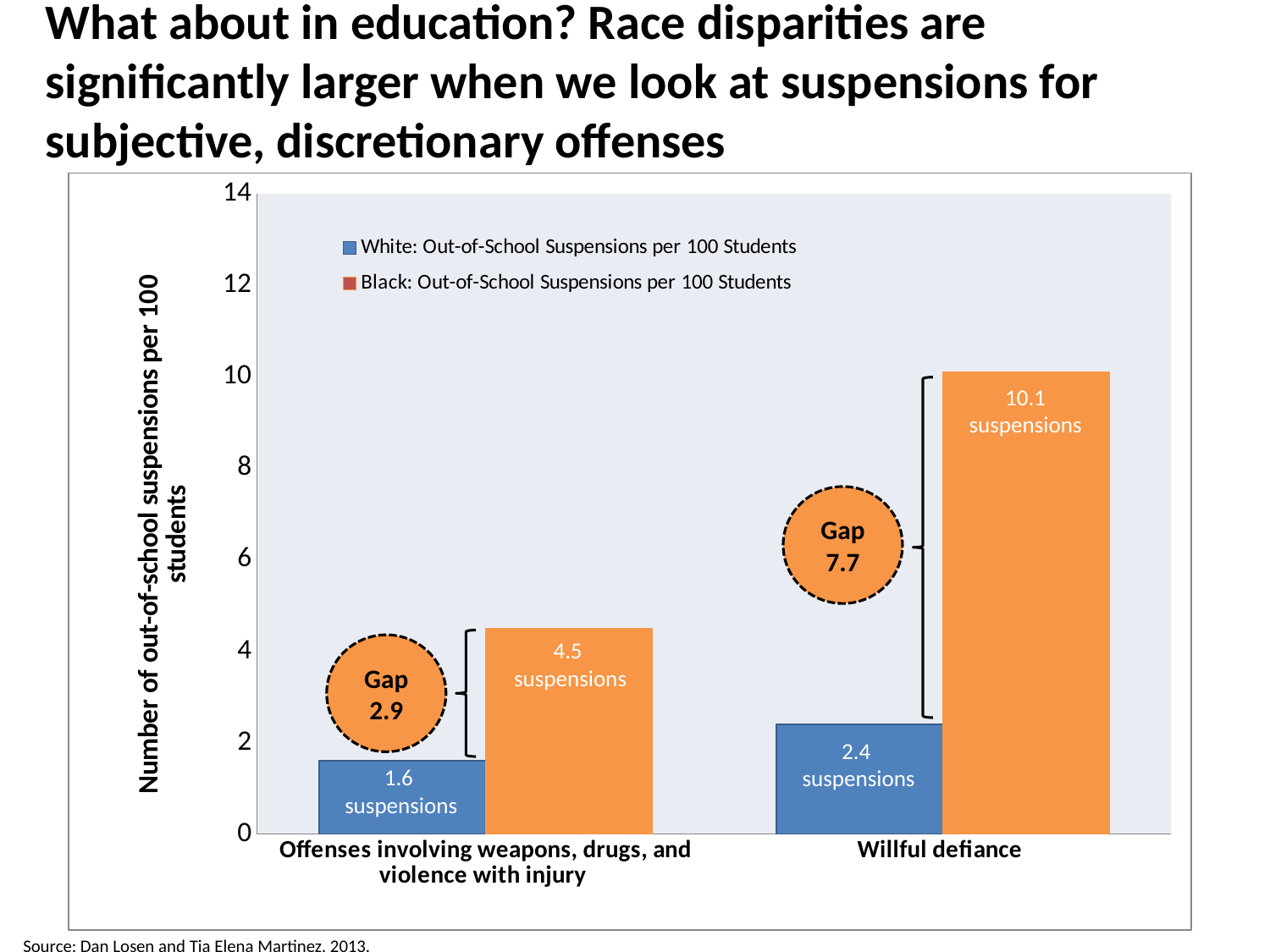
What is the value for Black students for Offenses involving weapons, drugs, and violence with injury? 4.5 suspensions Which is larger for Willful defiance: the value for White students or for Black students? Black students What is the gap between Black and White suspensions for Willful defiance? 7.7 How many categories are shown on the x axis? 2 Which category has the lowest value for White students? Offenses involving weapons, drugs, and violence with injury What is the gap between Black and White suspensions for Offenses involving weapons, drugs, and violence with injury? 2.9 What is the value for White students for Willful defiance? 2.4 suspensions Which category has the highest value for Black students? Willful defiance What kind of chart is shown? Bar chart What is the value for White students for Offenses involving weapons, drugs, and violence with injury? 1.6 suspensions How many series does the legend list? 2 What is the value for Black students for Willful defiance? 10.1 suspensions